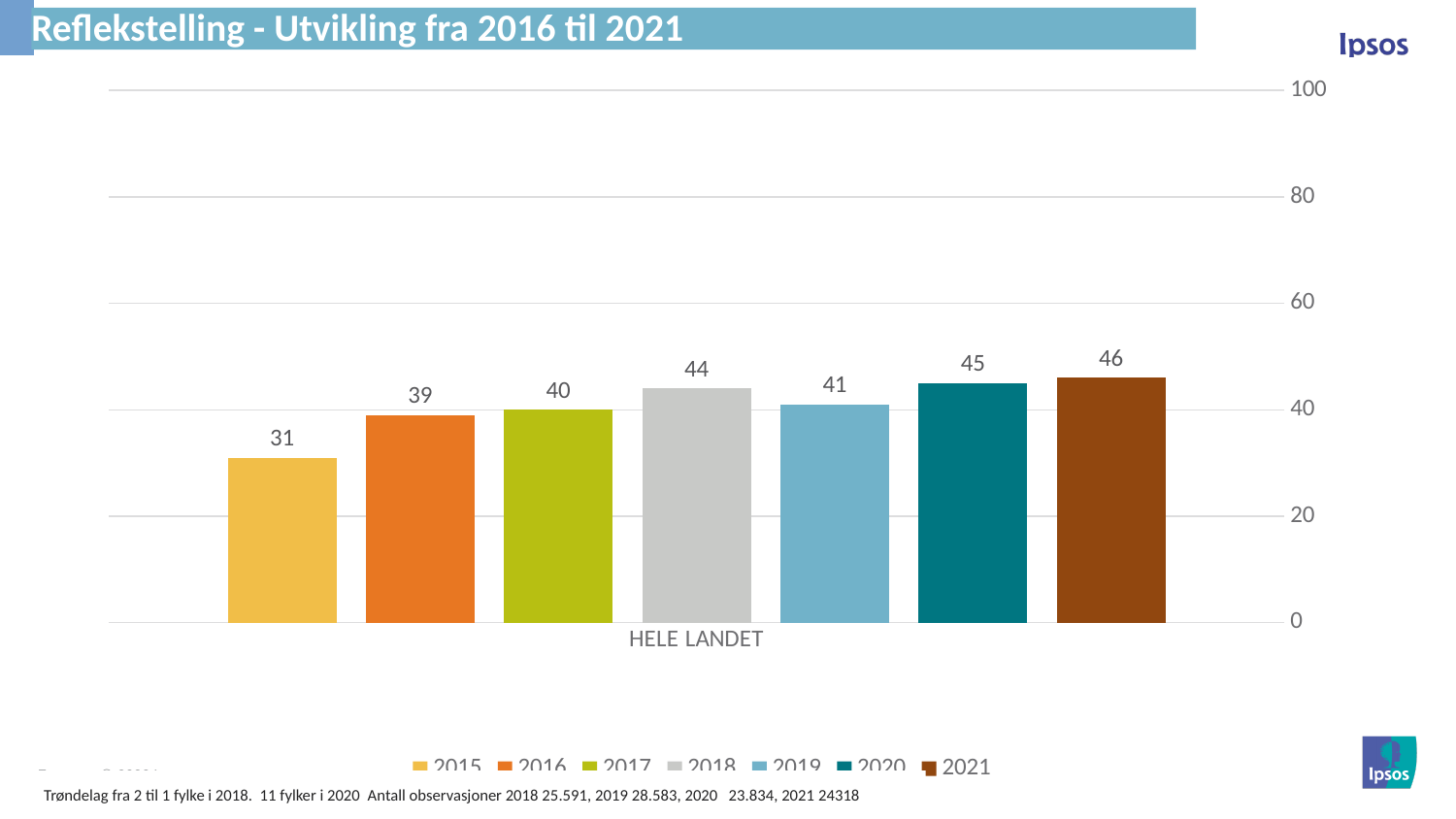
What is the value for 2018 in the chart? 44 Which is larger, the value for 2016 or the value for 2020? 2020 What is the category label shown on the x axis of the chart? HELE LANDET What is the value for 2015 in the chart? 31 Which year has the lowest value in the chart? 2015 What is the difference between the values for 2018 and 2019? 3 What is the value for 2021 in the chart? 46 Is the value for 2017 greater or less than 60? less How many series does the legend list? 7 Which year has the highest value in the chart? 2021 What is the difference between the values for 2021 and 2015? 15 What kind of chart is shown on the slide? bar chart